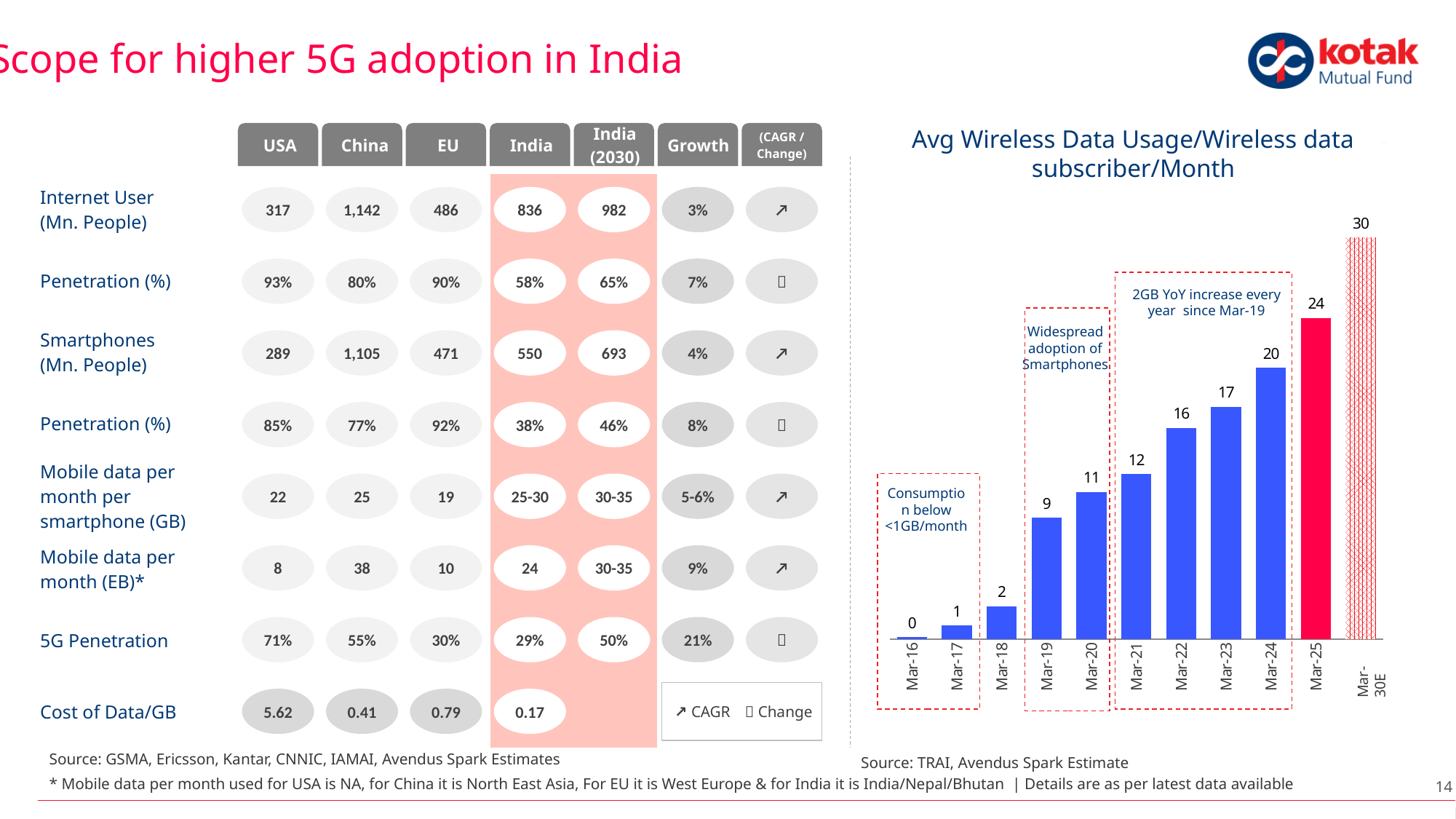
How many periods are plotted in the Avg Wireless Data Usage chart? 11 What type of chart is shown on the slide? bar chart Which is larger in the Avg Wireless Data Usage chart, the value for Mar-22 or the value for Mar-21? Mar-22 What is the difference between the values for Mar-25 and Mar-24 in the Avg Wireless Data Usage chart? 4 What is the value for Mar-19 in the Avg Wireless Data Usage chart? 9 Do the values in the Avg Wireless Data Usage chart rise or fall from Mar-16 to Mar-30E? rise Which period has the highest value in the Avg Wireless Data Usage chart? Mar-30E What is the difference between the values for Mar-20 and Mar-19 in the Avg Wireless Data Usage chart? 2 What is the value for Mar-30E in the Avg Wireless Data Usage chart? 30 What is the value for Mar-24 in the Avg Wireless Data Usage chart? 20 Which period has the lowest value in the Avg Wireless Data Usage chart? Mar-16 What is the value for Mar-25 in the Avg Wireless Data Usage chart? 24